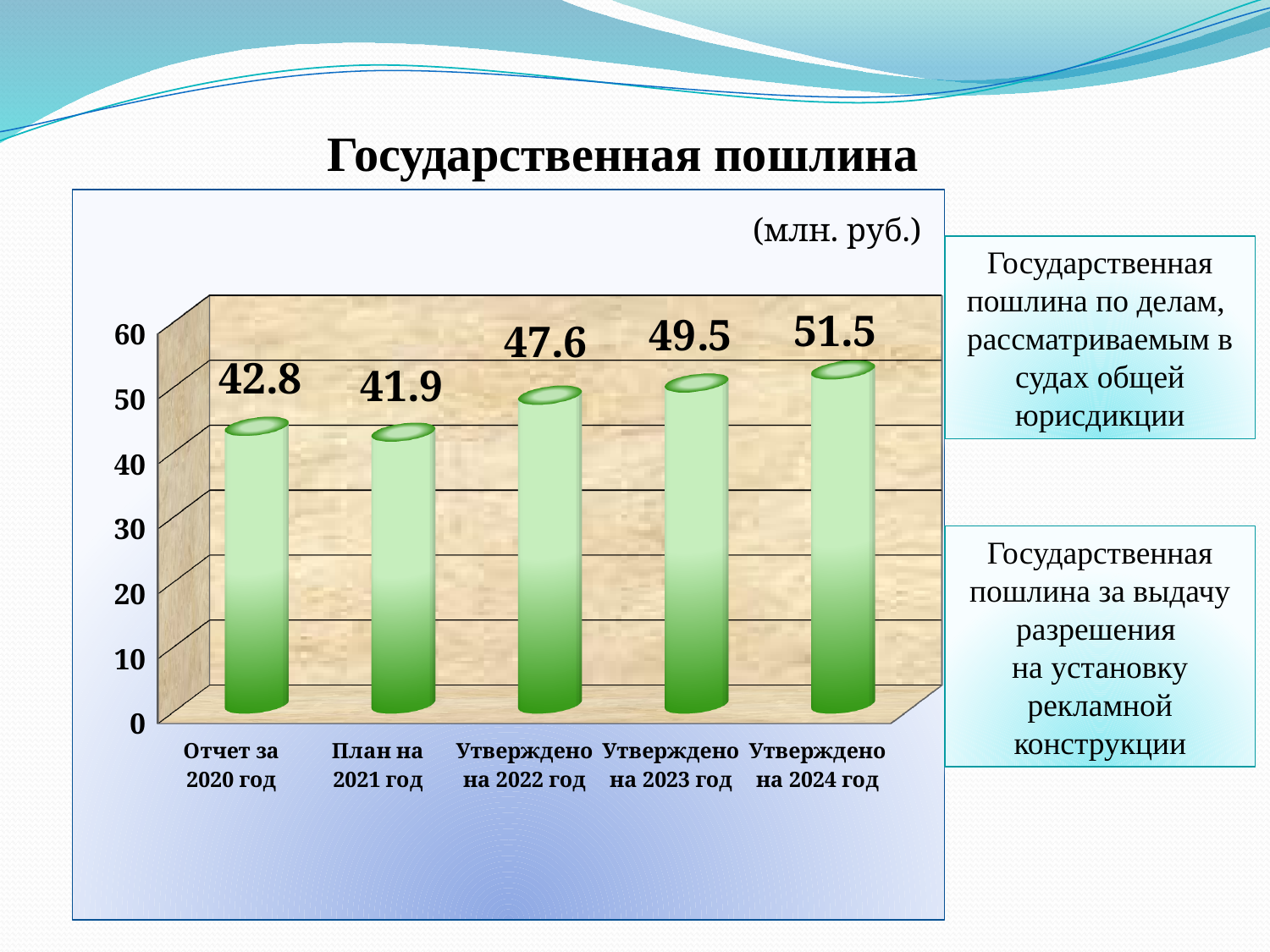
Which is larger: the value for "Утверждено на 2022 год" or "Утверждено на 2023 год"? Утверждено на 2023 год Which category has the highest value? Утверждено на 2024 год Do the values rise or fall from "План на 2021 год" to "Утверждено на 2024 год"? rise What is the title of the chart? Государственная пошлина What kind of chart is shown on the slide? bar chart How many categories are shown on the chart? 5 What is the difference between the values for "Утверждено на 2024 год" and "Отчет за 2020 год"? 8.7 Which category has the lowest value? План на 2021 год What is the value for "План на 2021 год"? 41.9 Is the value for "Утверждено на 2024 год" greater or less than 50? greater What is the value for "Отчет за 2020 год"? 42.8 What is the value for "Утверждено на 2024 год"? 51.5